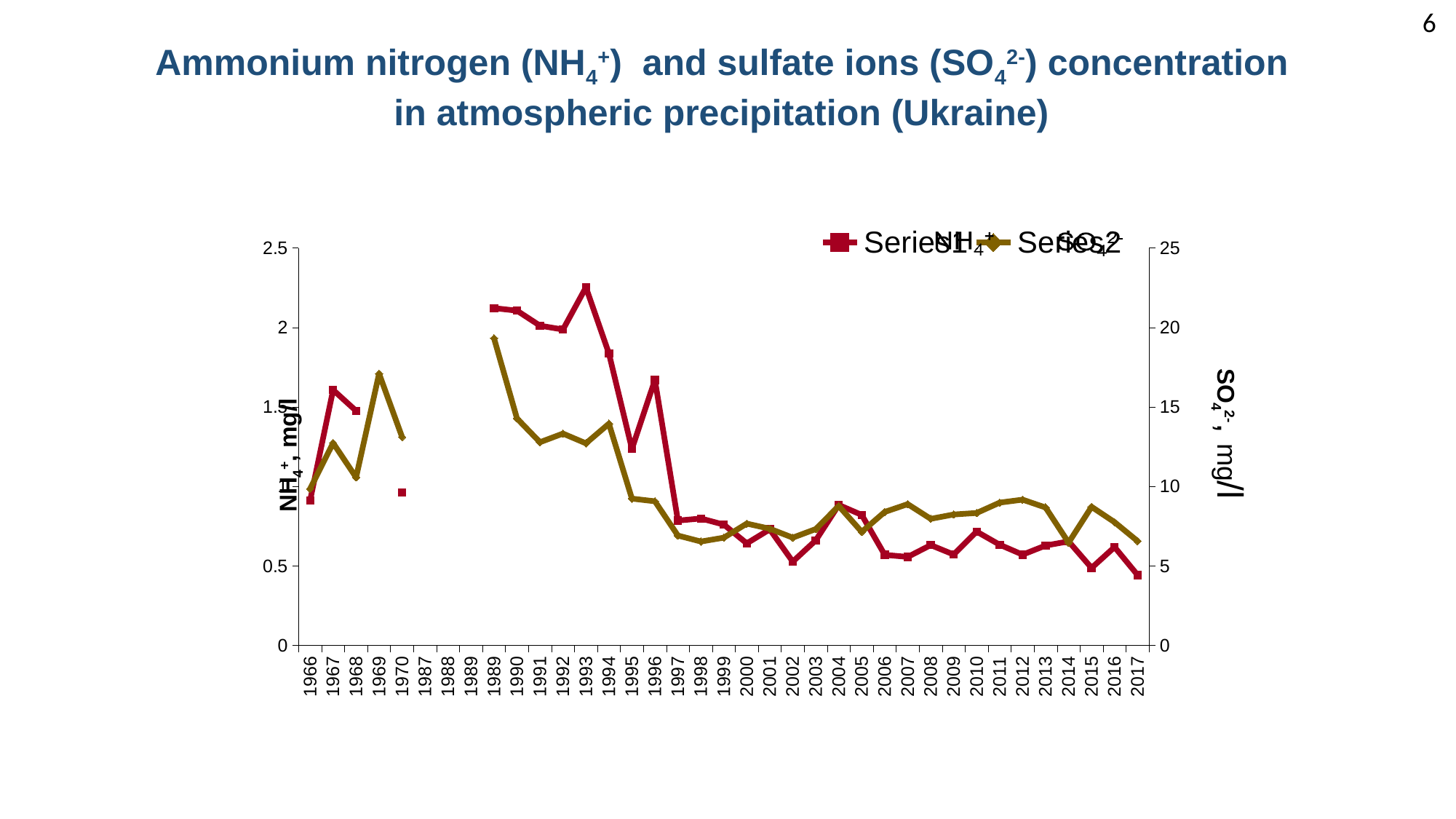
In which year does the NH4+ series reach its highest value? 1993 Is the SO4 2- value for 1989 greater or less than 15? greater Is the NH4+ value for 1993 greater or less than 2? greater Which year has the higher NH4+ value, 1993 or 1996? 1993 Does the NH4+ series overall rise or fall from 1989 to 2017? fall How many series does the legend list? 2 Is the SO4 2- value for 2002 greater or less than 10? less What is the label of the right-hand vertical axis? SO4 2-, mg/l In which year does the SO4 2- series reach its highest value? 1989 What kind of chart is shown on the slide? line chart